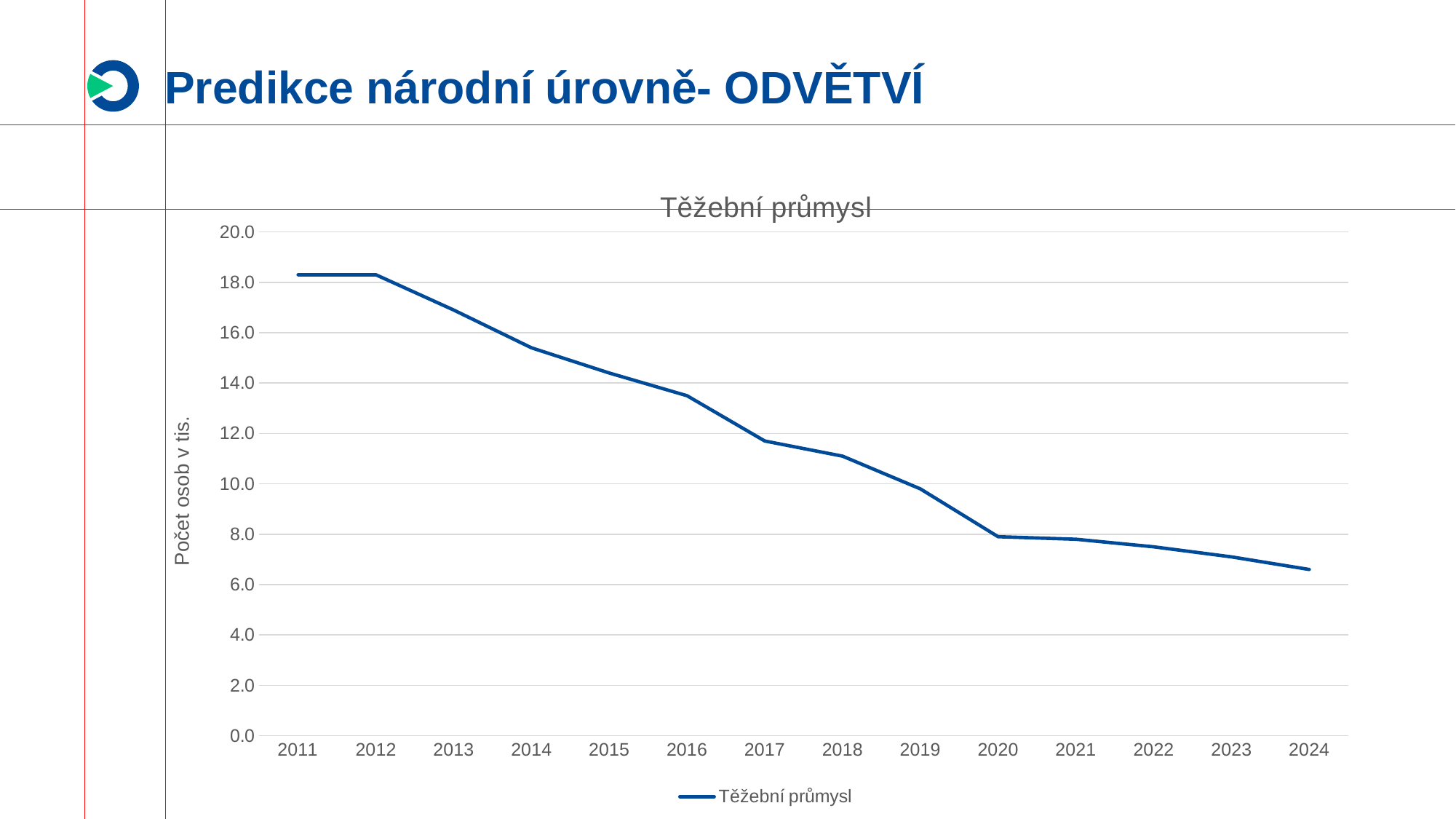
What is the label of the vertical axis? Počet osob v tis. What kind of chart is shown on the slide? line chart Which year has the larger value, 2014 or 2018? 2014 Is the value for 2024 greater or less than 6.0? greater How many series does the legend list? 1 Is the value for 2011 greater or less than 18.0? greater How many years are plotted along the x axis? 14 Is the value for 2016 greater or less than 14.0? less Which year has the lowest value? 2024 Do the values rise or fall from 2011 to 2024? fall What is the title of the chart? Těžební průmysl